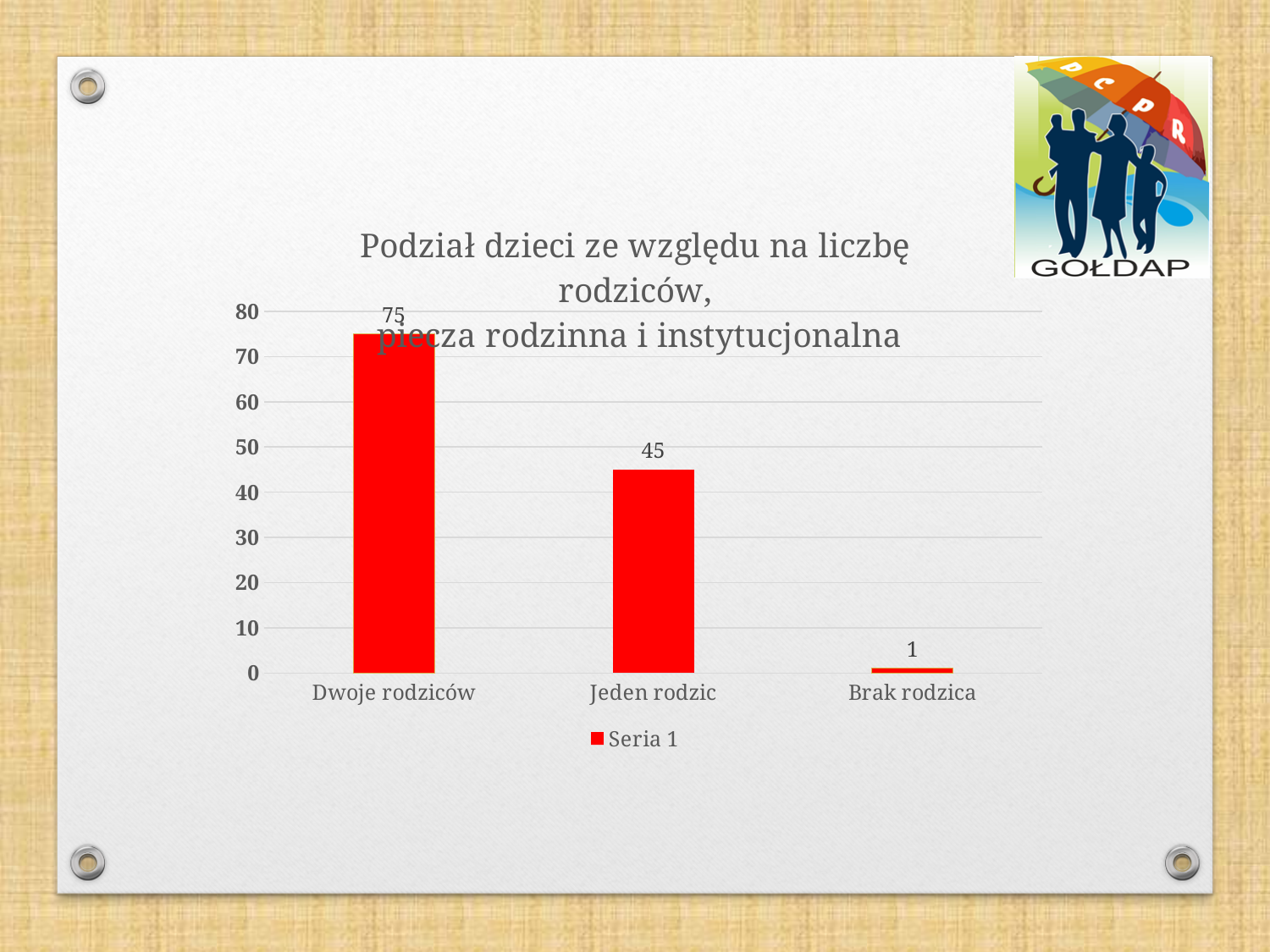
What is the value for Dwoje rodziców? 75 Which category has the highest value? Dwoje rodziców What kind of chart is shown on the slide? bar chart How many series does the legend list? 1 What is the value for Brak rodzica? 1 Which is larger, the value for Jeden rodzic or the value for Brak rodzica? Jeden rodzic What is the difference between the values for Jeden rodzic and Brak rodzica? 44 Which category has the lowest value? Brak rodzica What is the name of the series shown in the legend? Seria 1 What is the difference between the values for Dwoje rodziców and Jeden rodzic? 30 What is the value for Jeden rodzic? 45 How many categories are shown on the x axis? 3